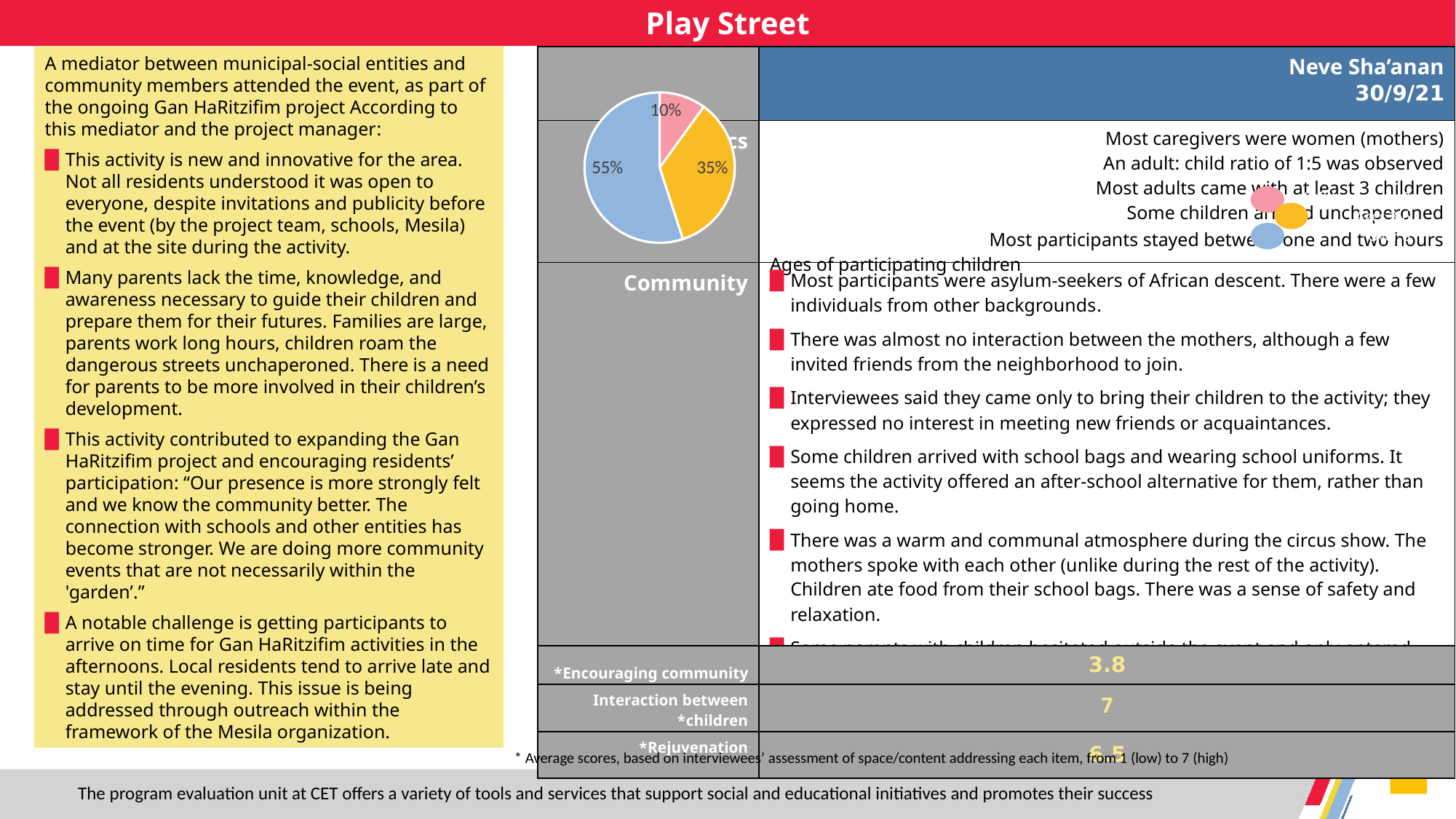
What percentage is shown on the orange slice of the pie chart? 35% What is the value of the largest slice of the pie chart? 55% What kind of chart is shown on the slide? pie chart What colour is the slice representing 10% in the pie chart? pink Which slice of the pie chart is larger, the blue one or the orange one? the blue one What percentage is shown on the pink slice of the pie chart? 10% What is the value of the smallest slice of the pie chart? 10% How many slices does the pie chart have? 3 What percentage is shown on the blue slice of the pie chart? 55% What is the difference in percentage points between the largest and smallest slices of the pie chart? 45 Is the value of the orange slice of the pie chart greater or less than 50%? less